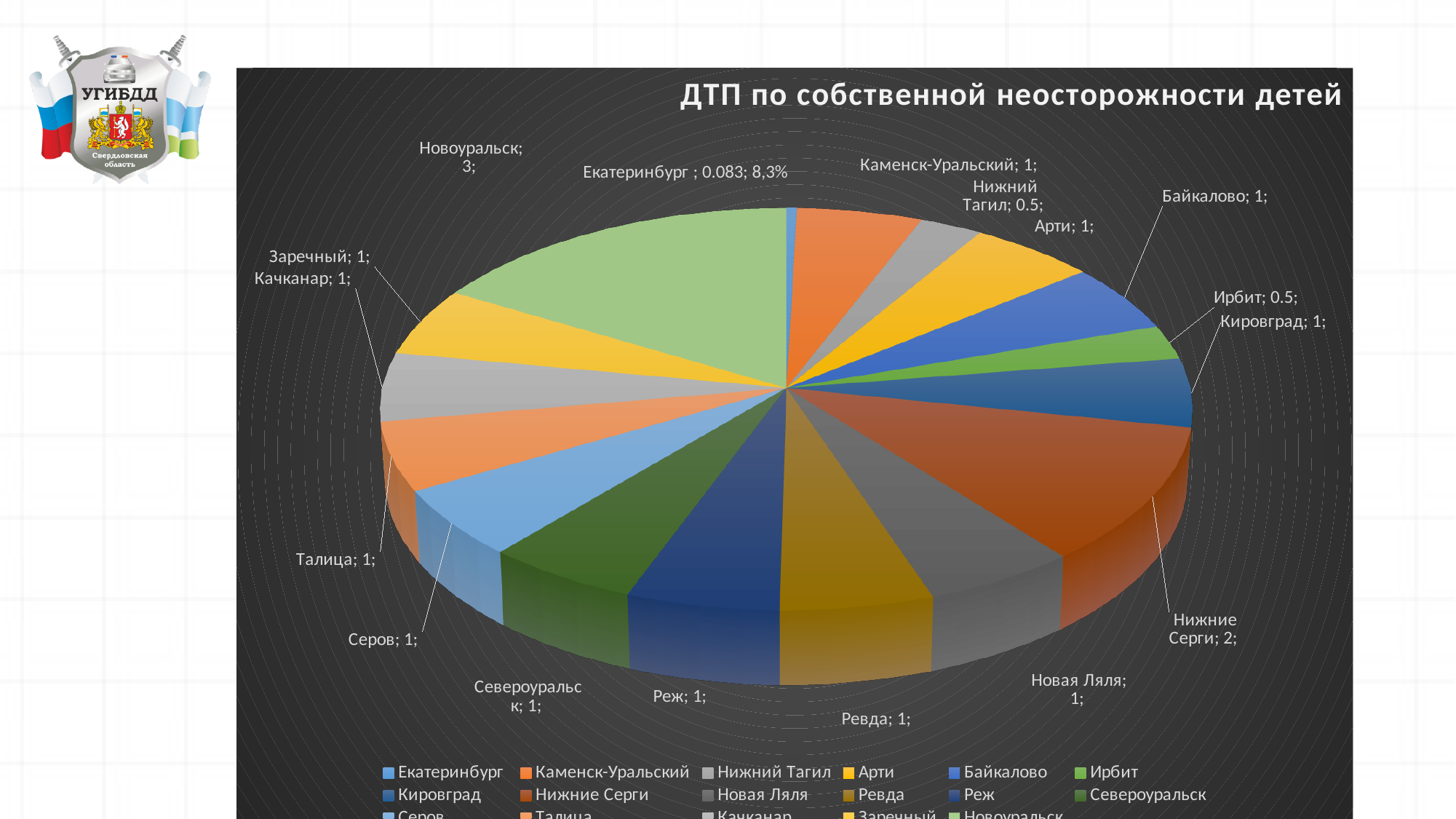
What is the value shown for Ирбит? 0.5 What is the value shown for Новоуральск? 3 What is the title of the chart? ДТП по собственной неосторожности детей What percentage share is shown for Екатеринбург? 8,3% What type of chart is shown on the slide? pie chart Which has the larger value, Арти or Нижний Тагил? Арти Which category has the largest value in the chart? Новоуральск What is the value shown for Нижние Серги? 2 How many categories does the legend list? 17 What is the difference between the values for Новоуральск and Нижние Серги? 1 What is the value shown for Нижний Тагил? 0.5 What is the value shown for Талица? 1